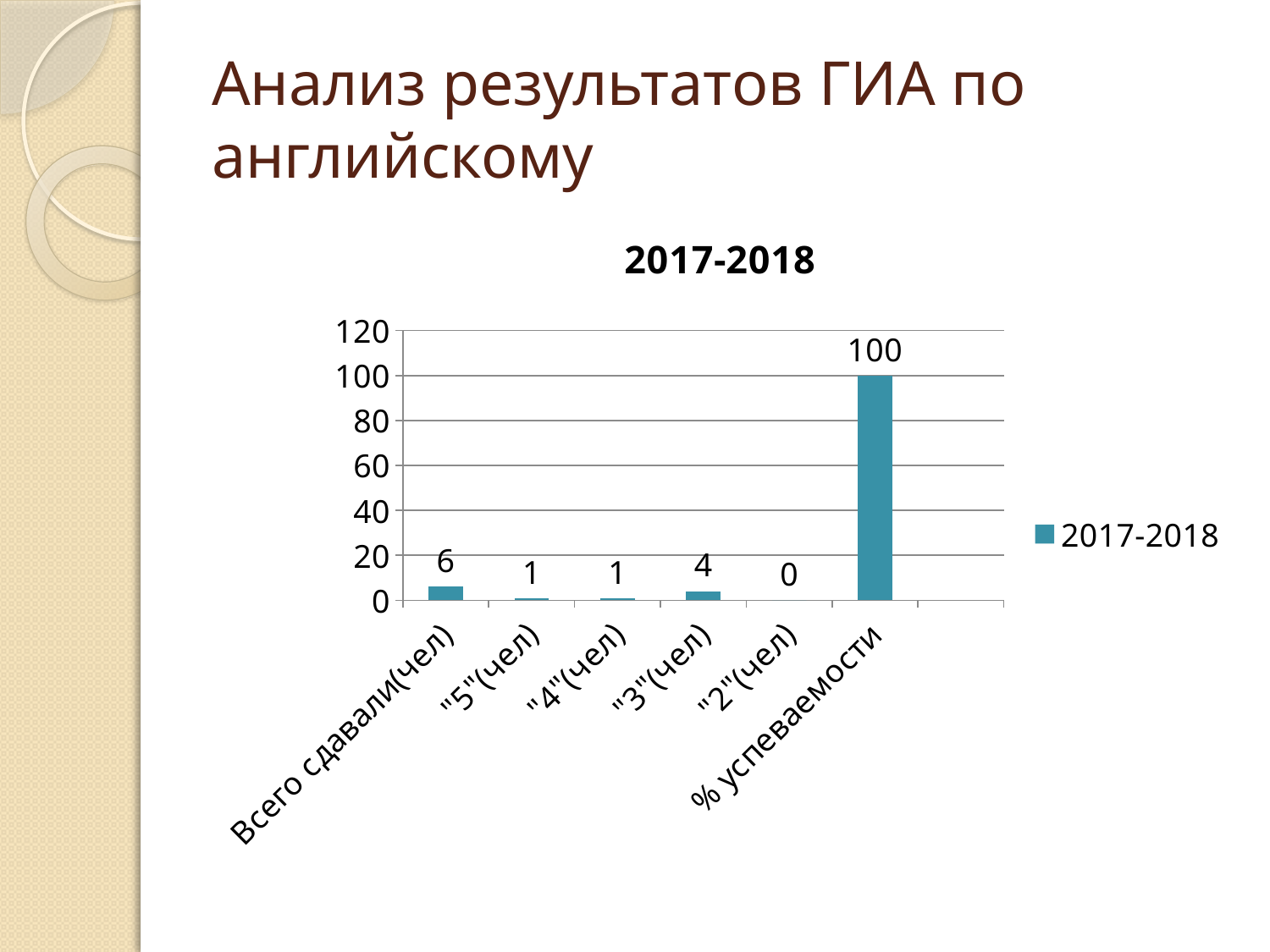
What is the value for "3"(чел)? 4 How many series does the legend list? 1 Which category has the highest value? % успеваемости What is the difference between the values for "Всего сдавали(чел)" and "3"(чел)? 2 Which category has the lowest value? "2"(чел) What kind of chart is shown? bar chart Which is larger, the value for "3"(чел) or the value for "5"(чел)? "3"(чел) What is the title of the chart? 2017-2018 How many categories are shown on the x axis? 6 What is the value for "% успеваемости"? 100 What is the value for "2"(чел)? 0 What is the value for "Всего сдавали(чел)"? 6